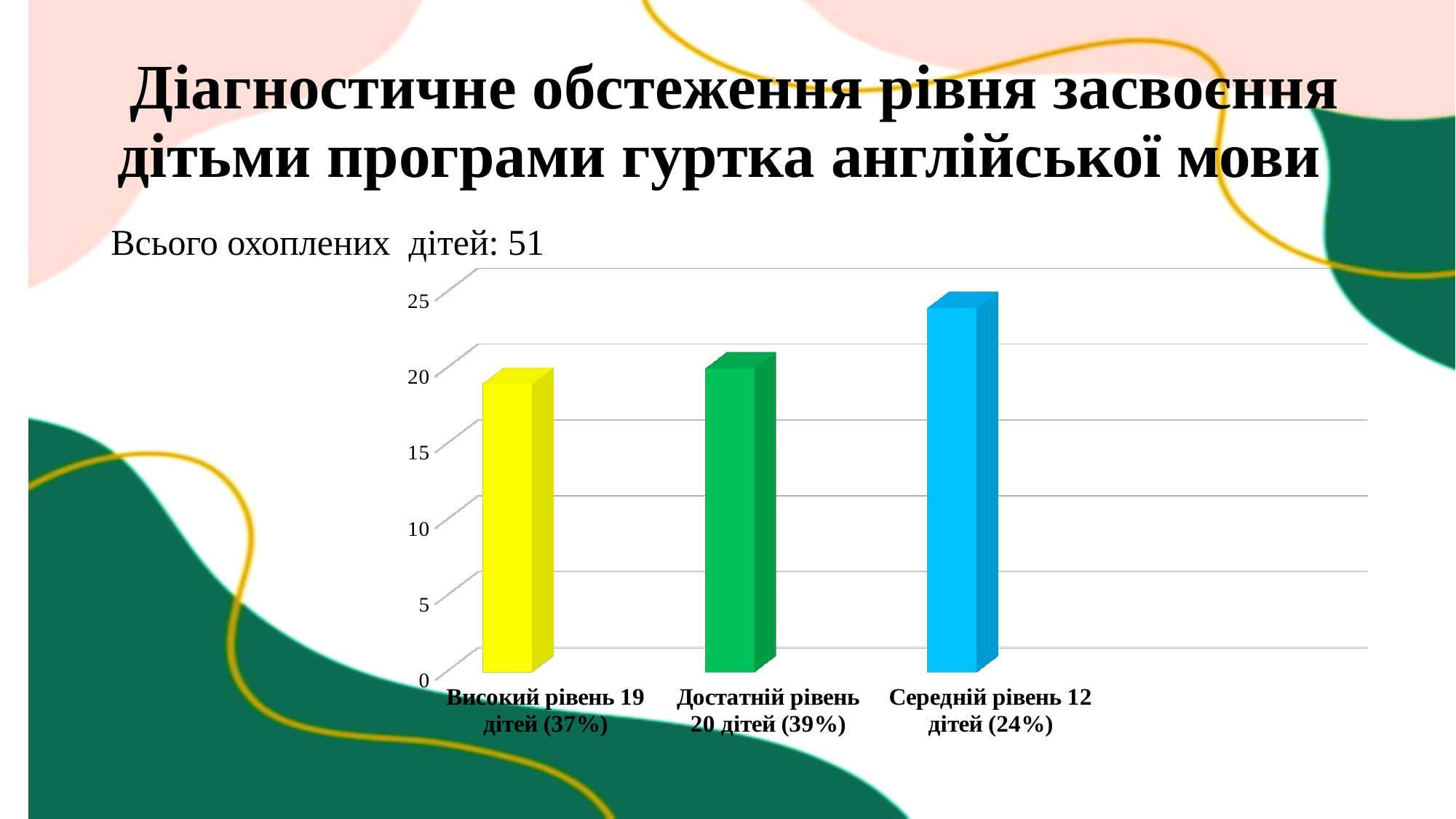
Is the value for the bar labelled "Високий рівень 19 дітей (37%)" greater or less than 15? greater What is the highest value shown on the vertical axis of the chart? 25 How many children are stated in the category label for "Високий рівень"? 19 What percentage is printed in the category label for "Достатній рівень"? 39% Which category has the highest bar in the chart? Середній рівень 12 дітей (24%) What colour is the tallest bar in the chart? blue Is the value for the bar labelled "Середній рівень 12 дітей (24%)" greater or less than 20? greater Is the value for the bar labelled "Достатній рівень 20 дітей (39%)" greater or less than 15? greater Is the bar for "Середній рівень" taller or shorter than the bar for "Високий рівень"? taller What kind of chart is shown on the slide? bar chart How many categories (bars) does the chart show? 3